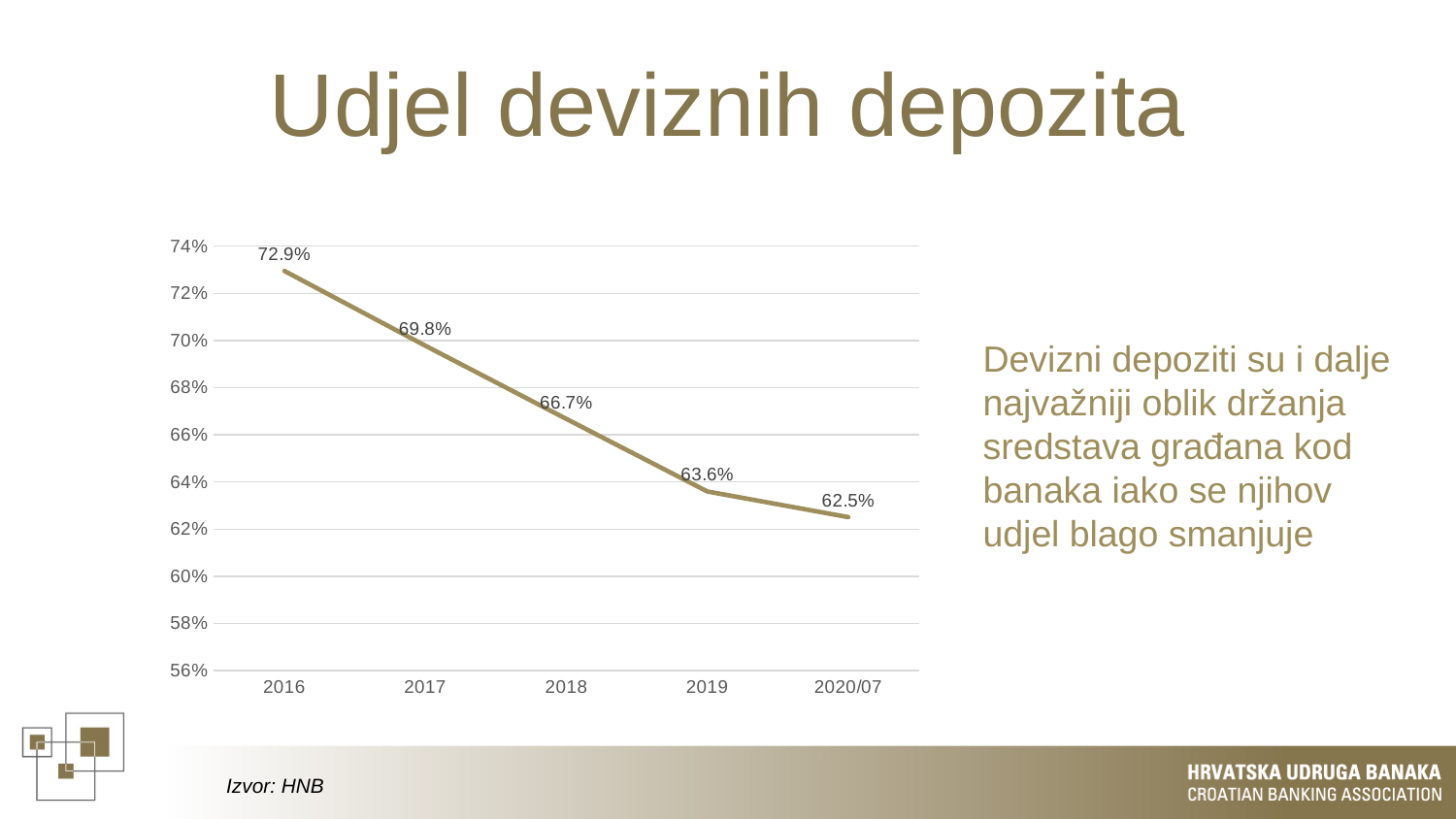
How many data points are plotted on the chart? 5 Which is larger, the value for 2017 or the value for 2019? 2017 Is the value for 2018 greater or less than 68%? less What is the value shown for 2018? 66.7% Which point on the chart has the lowest value? 2020/07 What is the value shown for 2020/07? 62.5% What is the share of foreign currency deposits in 2016? 72.9% What is the difference between the 2016 value and the 2017 value? 3.1% Which year has the highest value on the chart? 2016 What is the difference between the 2019 value and the 2020/07 value? 1.1% What kind of chart is shown on the slide? line chart Do the values rise or fall from 2016 to 2020/07? fall